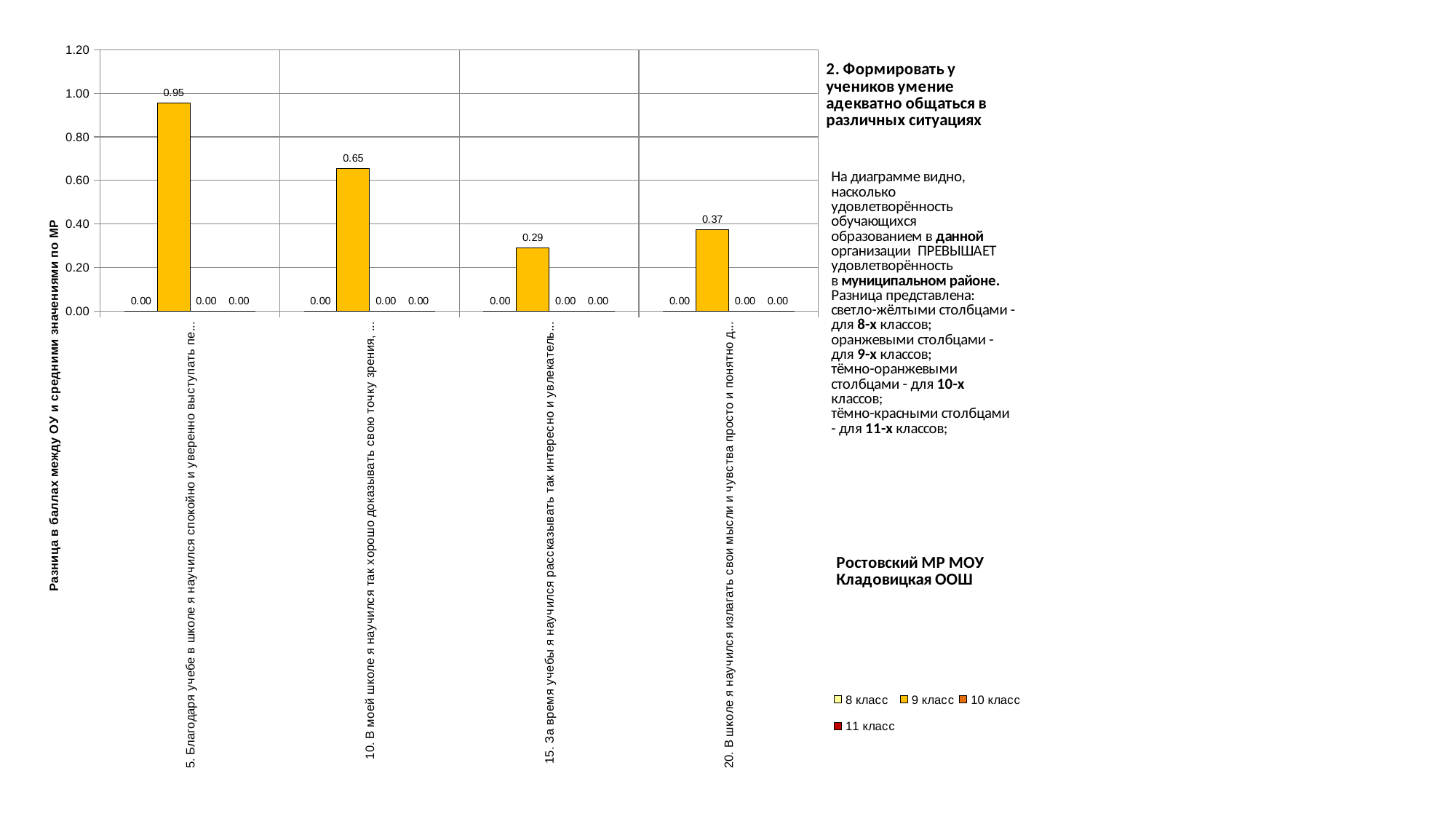
What is the value for 9 класс in category 5 ("Благодаря учебе в школе я научился спокойно и уверенно выступать...")? 0.95 What is the value for 9 класс in category 20 ("В школе я научился излагать свои мысли и чувства просто и понятно...")? 0.37 What type of chart is shown on the slide? Bar chart In which category does 9 класс have its lowest value? 15. За время учебы я научился рассказывать так интересно и увлекатель... In which category does 9 класс have its highest value? 5. Благодаря учебе в школе я научился спокойно и уверенно выступать... How many categories are shown on the x axis? 4 What is the value for 8 класс in category 5? 0.00 What is the value for 9 класс in category 10 ("В моей школе я научился так хорошо доказывать свою точку зрения...")? 0.65 How many series does the legend list? 4 Which is larger for 9 класс: the value in category 15 or the value in category 20? Category 20 (0.37) What is the difference between the 9 класс values in category 5 and category 10? 0.30 What is the value for 9 класс in category 15 ("За время учебы я научился рассказывать так интересно и увлекатель...")? 0.29